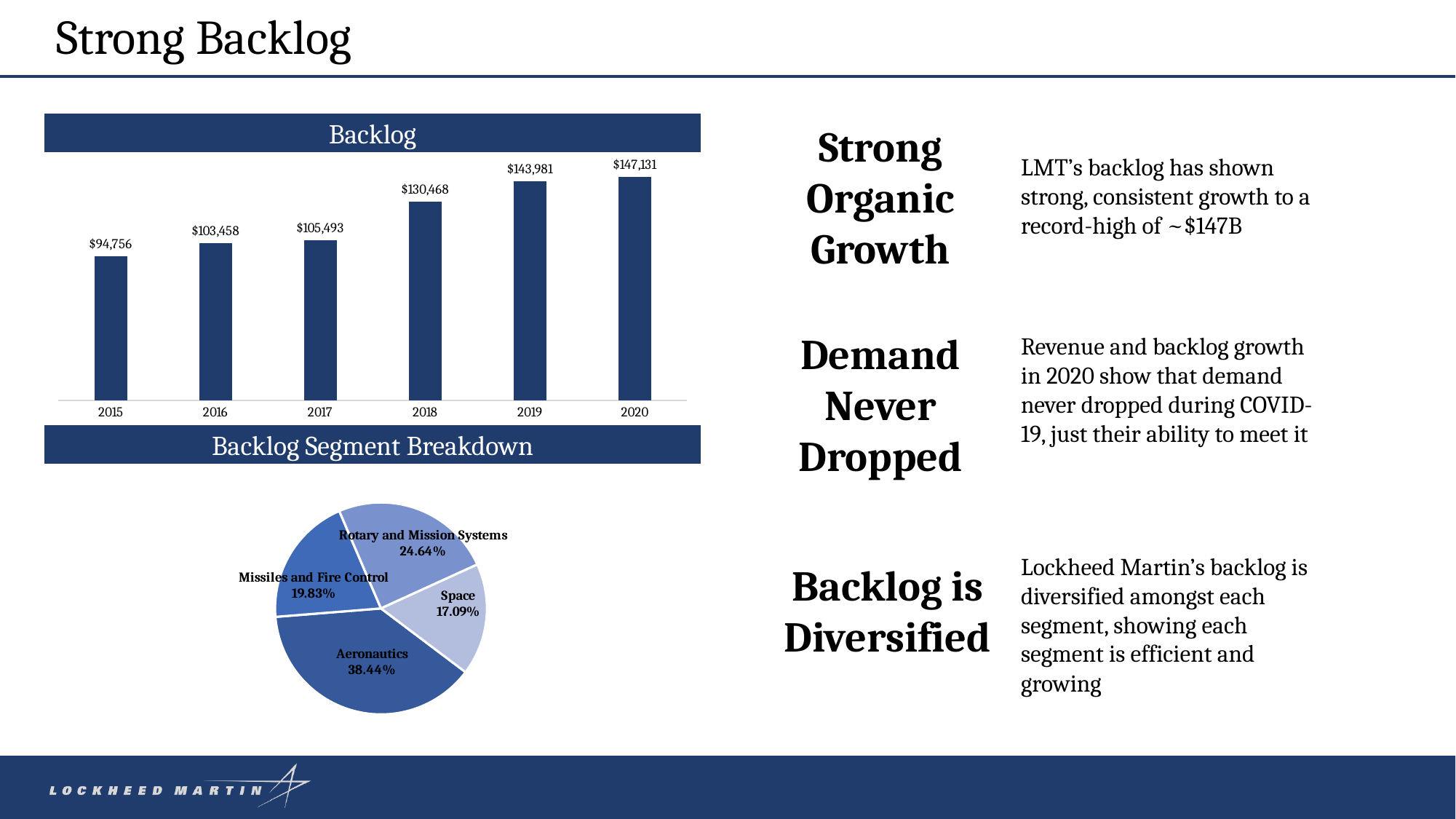
In the Backlog chart, which year has the highest backlog? 2020 In the Backlog chart, what is the difference between the 2020 and 2019 backlog values? $3,150 What kind of chart is the Backlog chart? Bar chart In the Backlog chart, which year has the lowest backlog? 2015 In the Backlog Segment Breakdown pie chart, which segment has the largest share? Aeronautics In the Backlog chart, which year has a larger backlog, 2017 or 2018? 2018 In the Backlog chart, do the values rise or fall from 2015 to 2020? Rise In the Backlog chart, how many years are shown on the x axis? 6 In the Backlog chart, what is the backlog value for 2015? $94,756 In the Backlog Segment Breakdown pie chart, how many segments are shown? 4 In the Backlog chart, what is the backlog value for 2018? $130,468 In the Backlog Segment Breakdown pie chart, what share does Space have? 17.09%